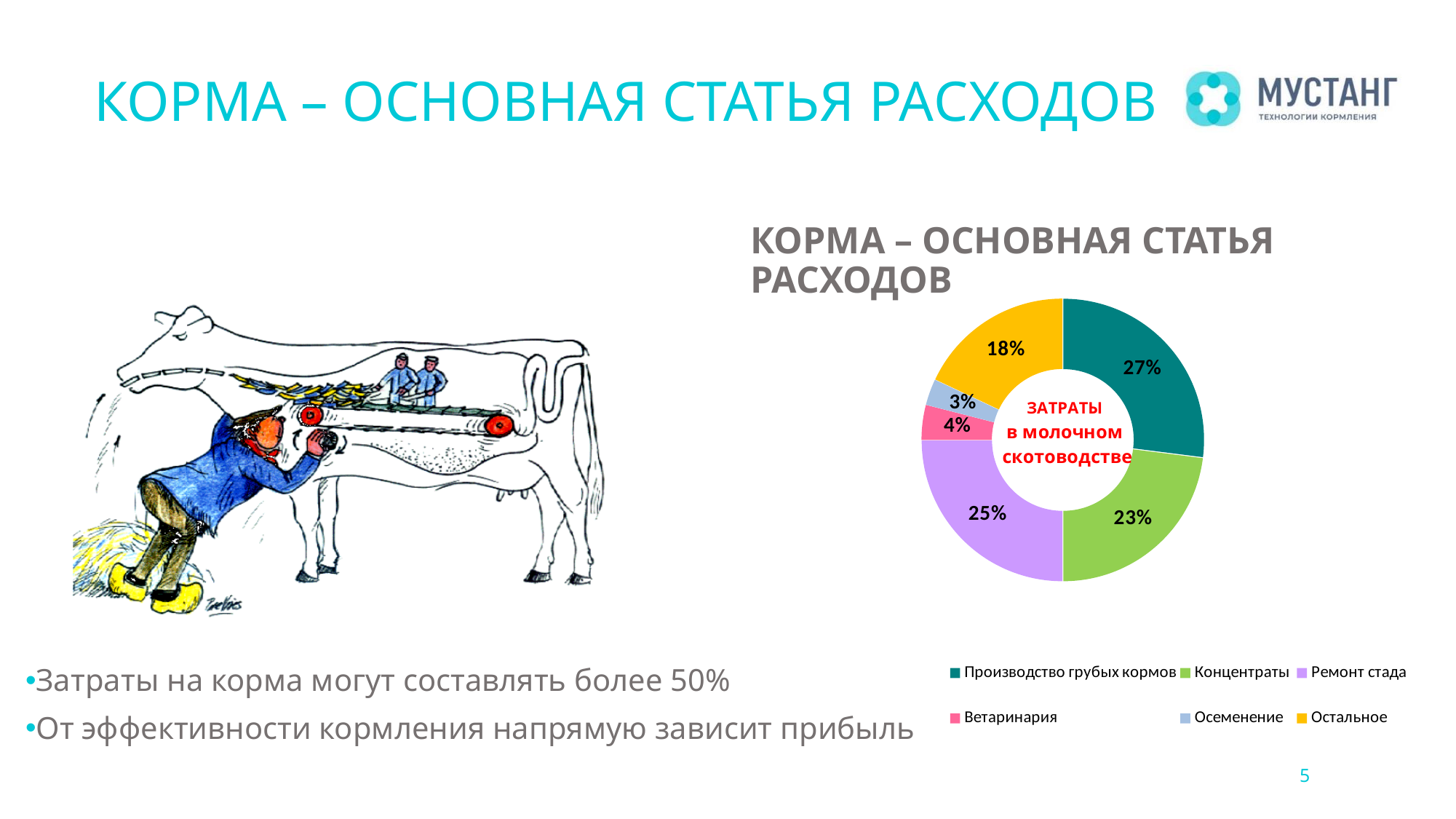
What type of chart is shown on the slide? Pie chart (donut) How many categories are shown in the chart? 6 Which category has the largest share of costs? Производство грубых кормов What is the value for Осеменение? 3% What percentage is shown for Ветаринария? 4% Which category has the smallest share of costs? Осеменение What text is written in the centre of the donut chart? ЗАТРАТЫ в молочном скотоводстве What is the value for Ремонт стада? 25% What percentage is shown for Концентраты? 23% What share of costs does Производство грубых кормов account for? 27% What is the difference between the shares of Производство грубых кормов and Остальное? 9% Which is larger, the share for Ремонт стада or the share for Концентраты? Ремонт стада